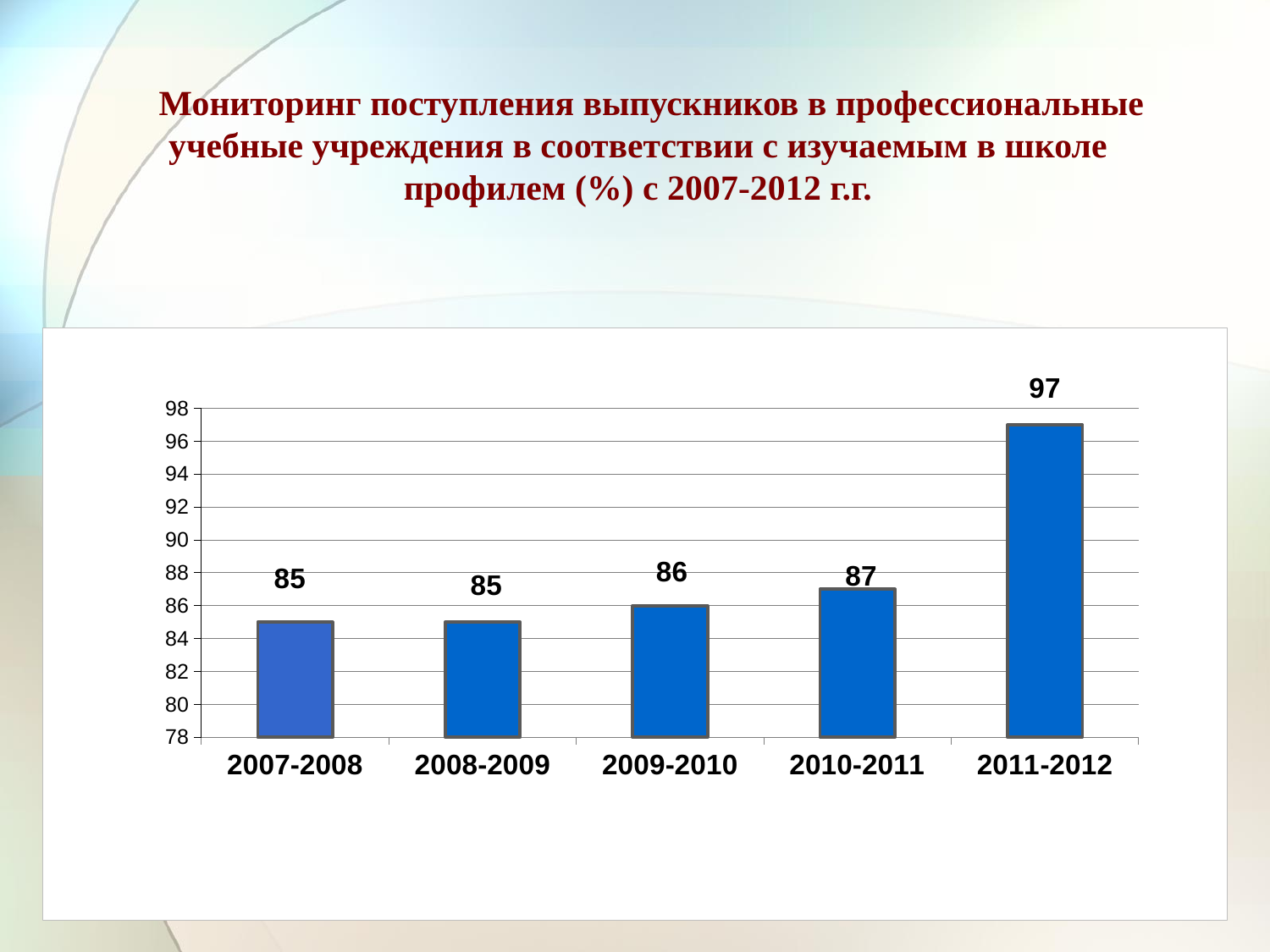
Is the value for 2011-2012 greater or less than 90? greater What is the difference between the values for 2011-2012 and 2010-2011? 10 What is the value for 2011-2012? 97 What is the value for 2010-2011? 87 Which is larger, the value for 2010-2011 or the value for 2009-2010? 2010-2011 Which period has the highest value? 2011-2012 What kind of chart is shown on the slide? bar chart What is the value for 2007-2008? 85 What is the difference between the values for 2009-2010 and 2008-2009? 1 Do the values rise or fall from 2007-2008 to 2011-2012? rise What is the value for 2009-2010? 86 How many periods are shown on the x axis? 5